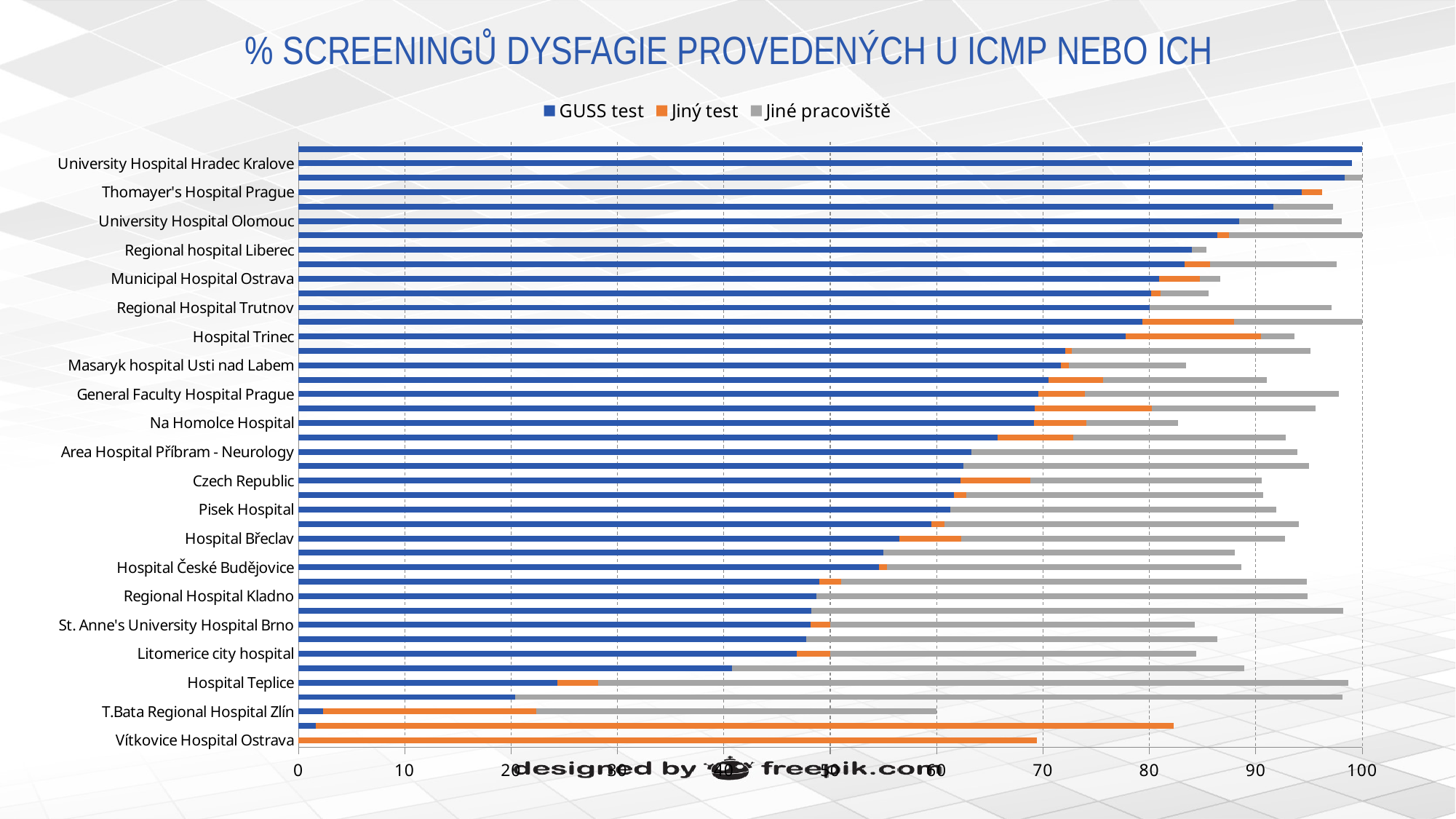
What kind of chart is shown on the slide? bar chart Is the Jiný test value for Vítkovice Hospital Ostrava greater or less than 60? greater Is the GUSS test value for University Hospital Hradec Kralove greater or less than 90? greater Do the GUSS test values rise or fall going from the top of the chart to the bottom? fall Is the GUSS test value for Regional Hospital Trutnov greater or less than 70? greater How many series does the legend list? 3 Which has the larger GUSS test value, University Hospital Olomouc or Litomerice city hospital? University Hospital Olomouc Which series is shown in orange in the legend? Jiný test What is the title of the chart? % SCREENINGŮ DYSFAGIE PROVEDENÝCH U ICMP NEBO ICH